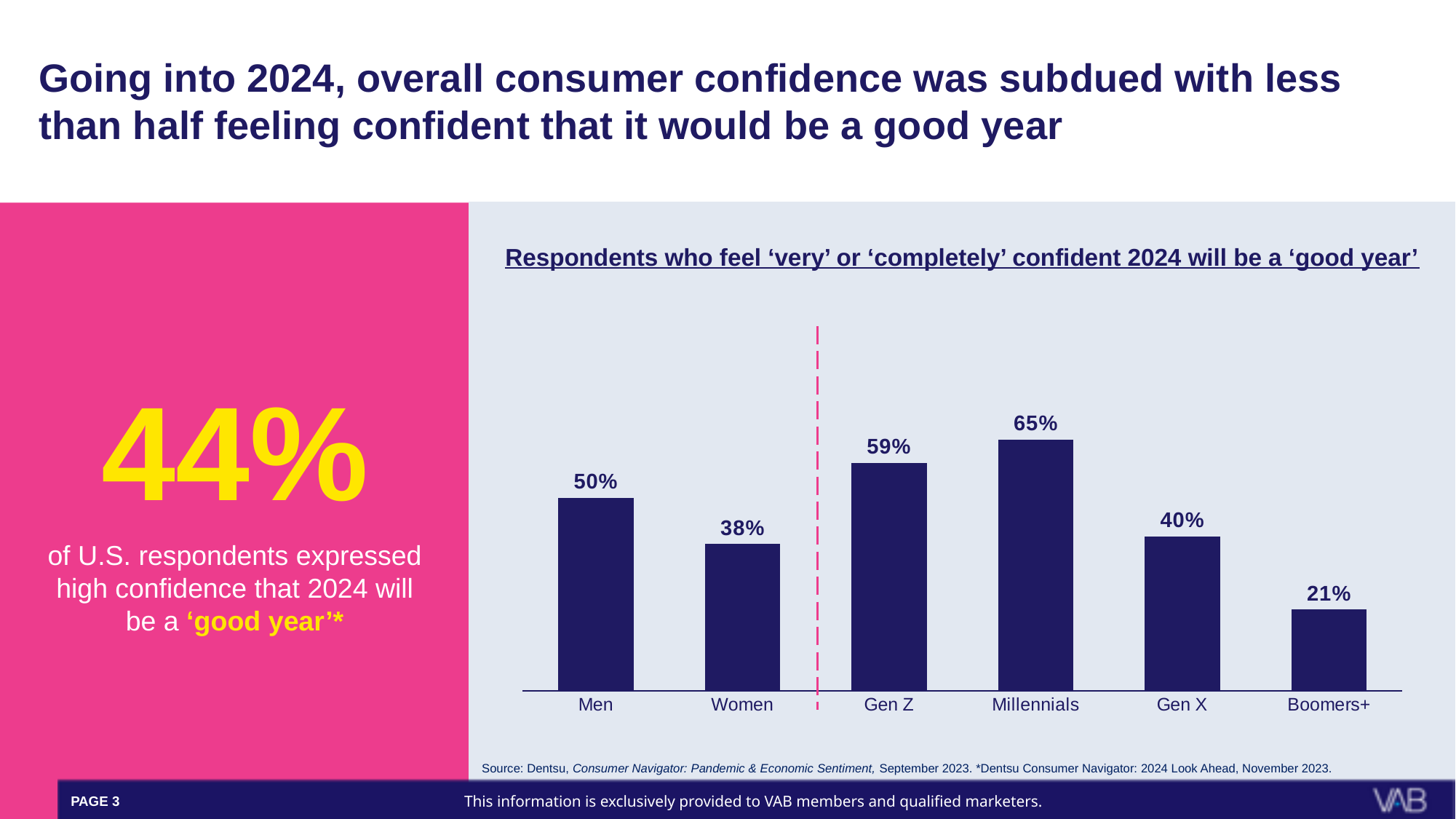
Which category has the highest value in the chart? Millennials What is the value shown for Women in the chart? 38% What is the value shown for Gen Z? 59% What percentage of Men feel 'very' or 'completely' confident 2024 will be a 'good year'? 50% What is the difference between the values for Men and Women? 12% What is the difference between the values for Millennials and Gen X? 25% Which category has the lowest value in the chart? Boomers+ Which has a higher value, Gen Z or Gen X? Gen Z What kind of chart is shown on the slide? Bar chart What is the value shown for Boomers+? 21% What is the title of the chart? Respondents who feel 'very' or 'completely' confident 2024 will be a 'good year' How many categories are shown in the chart? 6